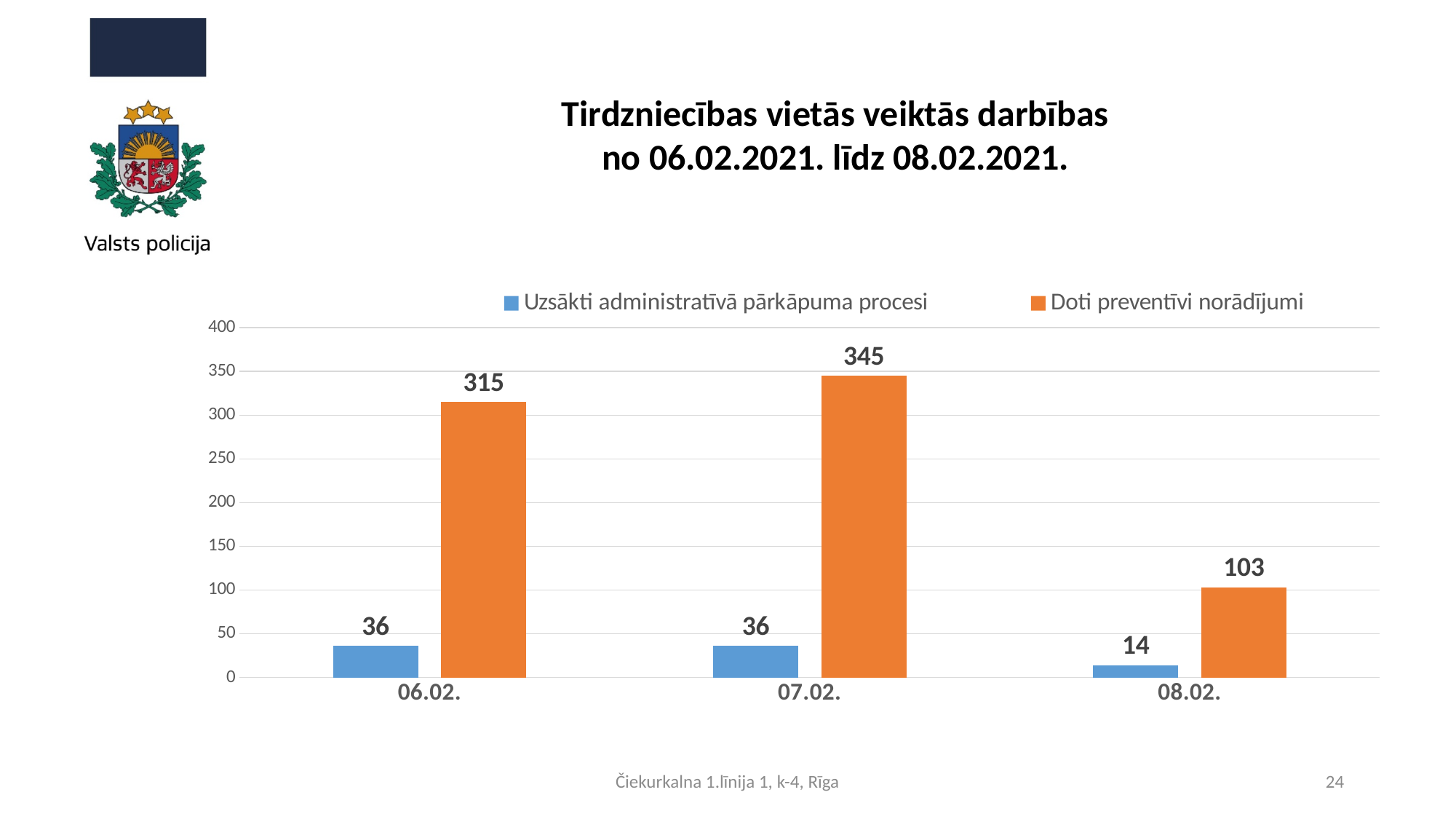
What is the value of 'Doti preventīvi norādījumi' on 06.02.? 315 How many series does the legend list? 2 What is the value of 'Doti preventīvi norādījumi' on 07.02.? 345 On which date is 'Uzsākti administratīvā pārkāpuma procesi' lowest? 08.02. How many dates are shown on the x axis? 3 What is the difference between 'Doti preventīvi norādījumi' on 07.02. and on 06.02.? 30 On which date is 'Doti preventīvi norādījumi' highest? 07.02. What kind of chart is shown on the slide? Bar chart What is the difference between 'Doti preventīvi norādījumi' and 'Uzsākti administratīvā pārkāpuma procesi' on 08.02.? 89 Which is larger on 06.02.: 'Uzsākti administratīvā pārkāpuma procesi' or 'Doti preventīvi norādījumi'? Doti preventīvi norādījumi What colour are the bars for 'Doti preventīvi norādījumi'? Orange What is the value of 'Uzsākti administratīvā pārkāpuma procesi' on 08.02.? 14